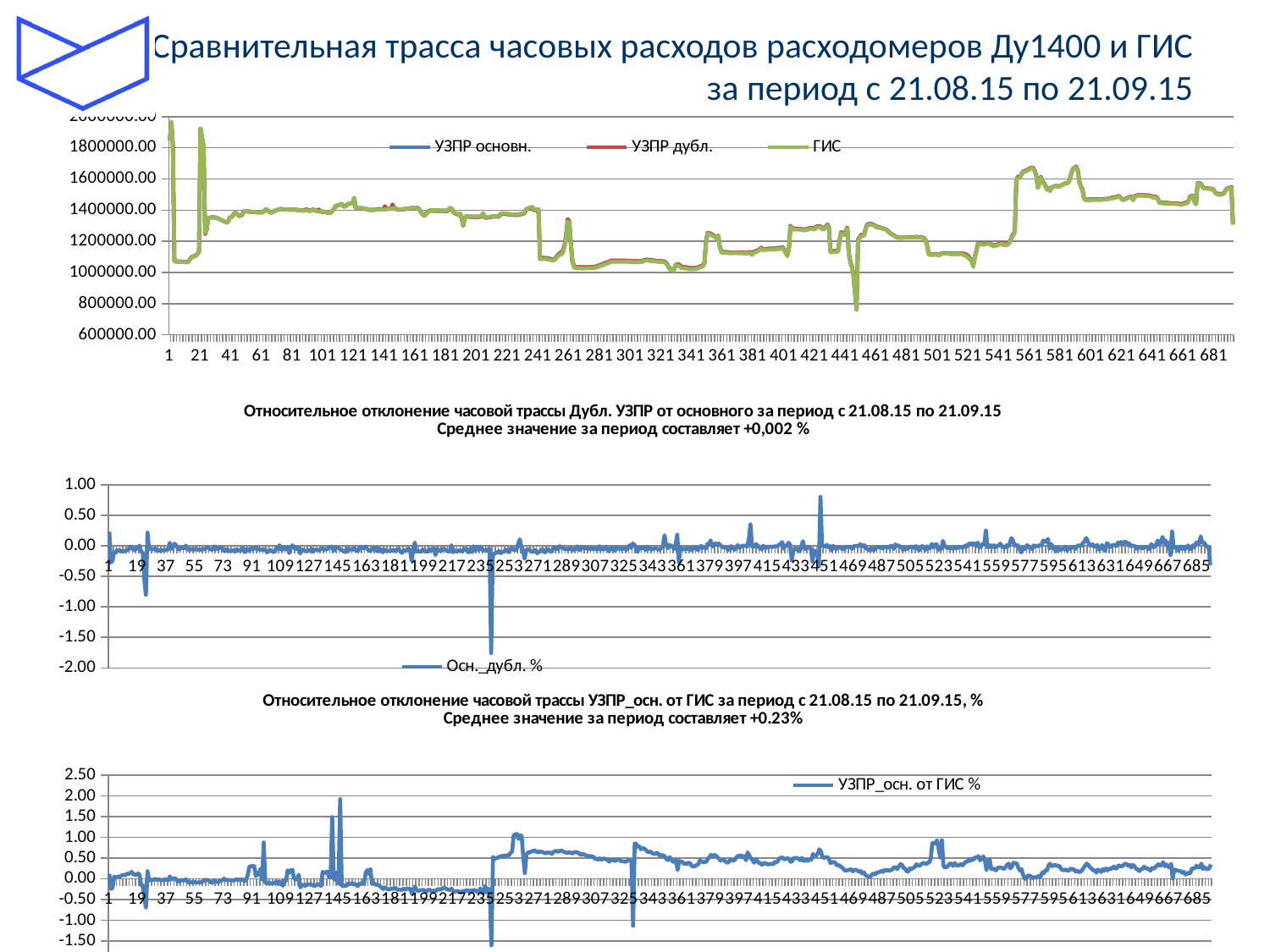
In the bottom chart, is the highest spike (around x = 145) greater or less than 1.50? greater What kind of chart is the top chart on the slide? line chart In the top chart, is the value at x = 1 greater or less than 1800000.00? greater What are the three series named in the legend of the top chart? УЗПР основн., УЗПР дубл., ГИС In the middle chart, is the highest positive spike (around x = 451) greater or less than 0.50? greater According to the title of the bottom chart, what is the average relative deviation of УЗПР_осн. from ГИС over the period? +0.23% According to the title of the middle chart, what is the average relative deviation of the duplicate УЗПР from the main one over the period? +0,002 % How many series does the legend of the middle chart list? 1 How many series does the legend of the top chart list? 3 What is the name of the series shown in the legend of the bottom chart? УЗПР_осн. от ГИС %